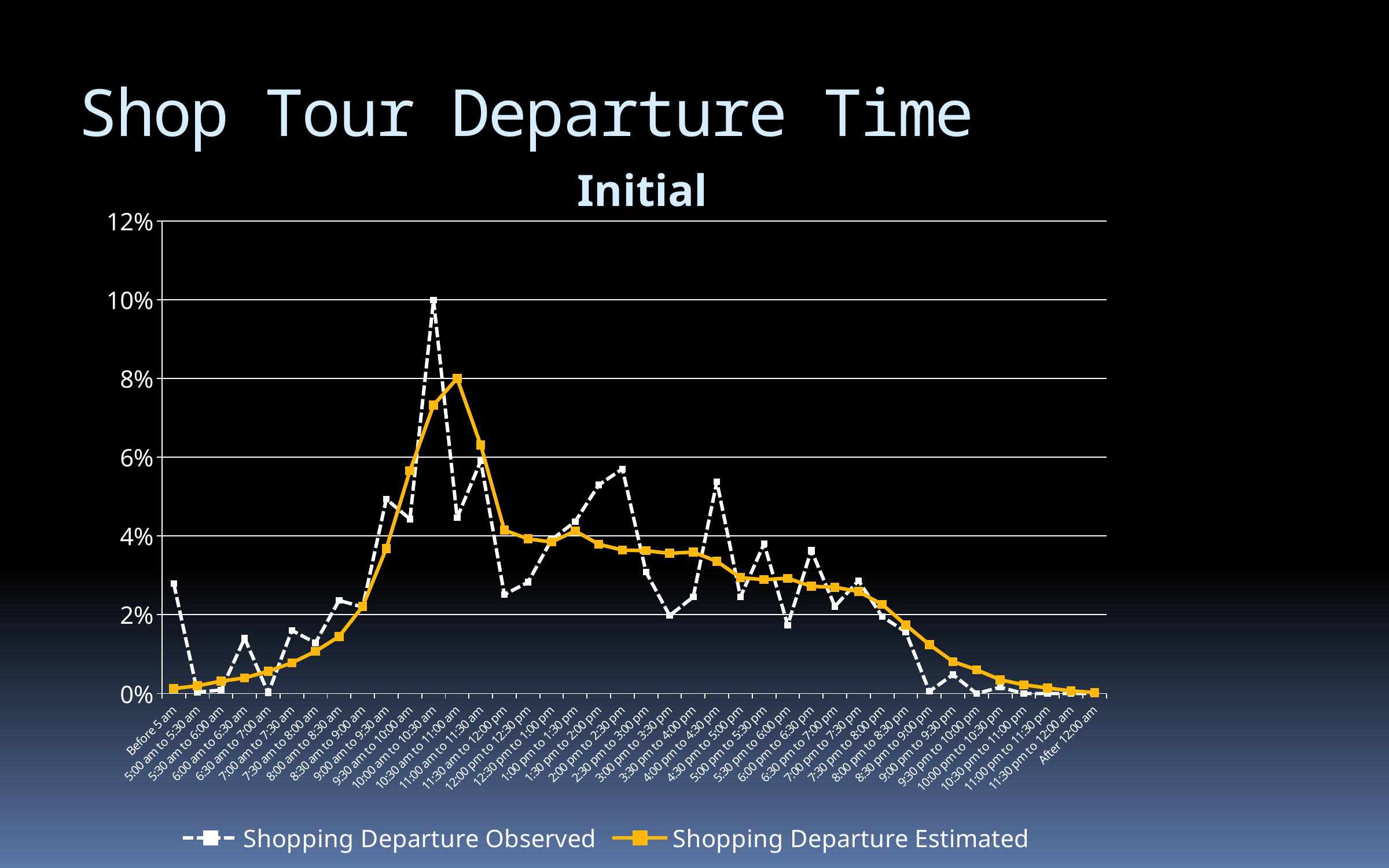
What is the title shown directly above the chart? Initial In which time slot does the Shopping Departure Observed series reach its highest value? 10:00 am to 10:30 am How many series does the legend list? 2 Is the value of Shopping Departure Observed for 2:30 pm to 3:00 pm greater or less than 4%? less In which time slot does the Shopping Departure Estimated series reach its highest value? 10:30 am to 11:00 am Which series is drawn with a dashed white line? Shopping Departure Observed Is the value of Shopping Departure Observed for 10:30 am to 11:00 am greater or less than 8%? less Is the value of Shopping Departure Estimated for 3:00 pm to 3:30 pm greater or less than 4%? less What kind of chart is shown on the slide? Line chart Does the Shopping Departure Estimated series rise or fall from 11:00 am to 11:30 am through to After 12:00 am? Fall For 11:00 am to 11:30 am, which series has the larger value, Shopping Departure Observed or Shopping Departure Estimated? Shopping Departure Estimated